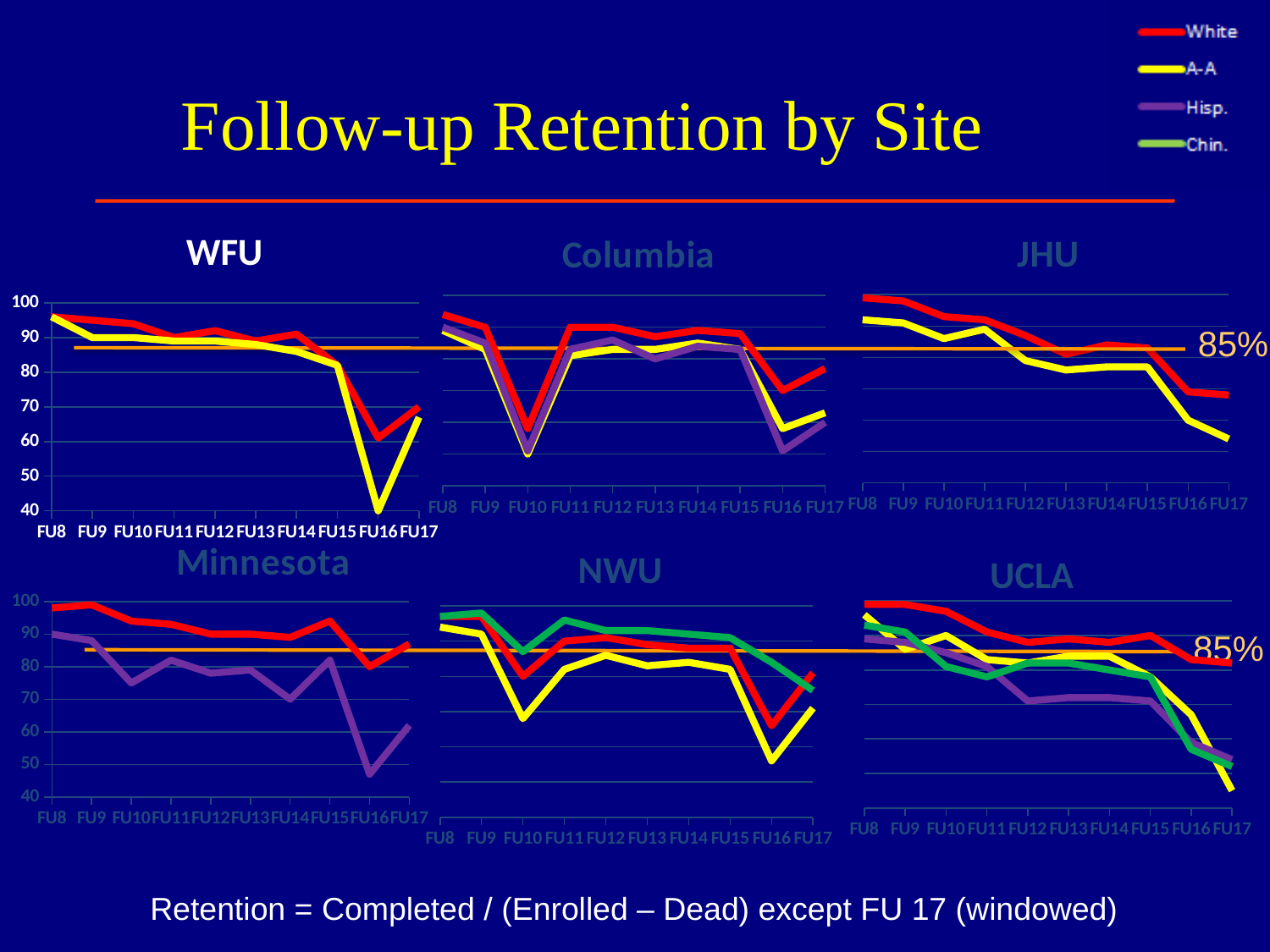
In the WFU chart, is the A-A value at FU16 greater or less than 50? less In the WFU chart, which series has the higher value at FU16, White or A-A? White In the Columbia chart, is the A-A value at FU10 greater or less than 70? less In the Minnesota chart, which series has the higher value at FU16, White or Hisp.? White In the JHU chart, is the White value at FU8 greater or less than 90? greater What kind of chart is the WFU chart? line chart How many series does the legend at the top right list? 4 What value is marked by the horizontal orange reference line on the JHU and UCLA charts? 85% How many follow-up points are plotted along the x axis of the WFU chart? 10 In the JHU chart, does the A-A line rise or fall from FU8 to FU17? fall